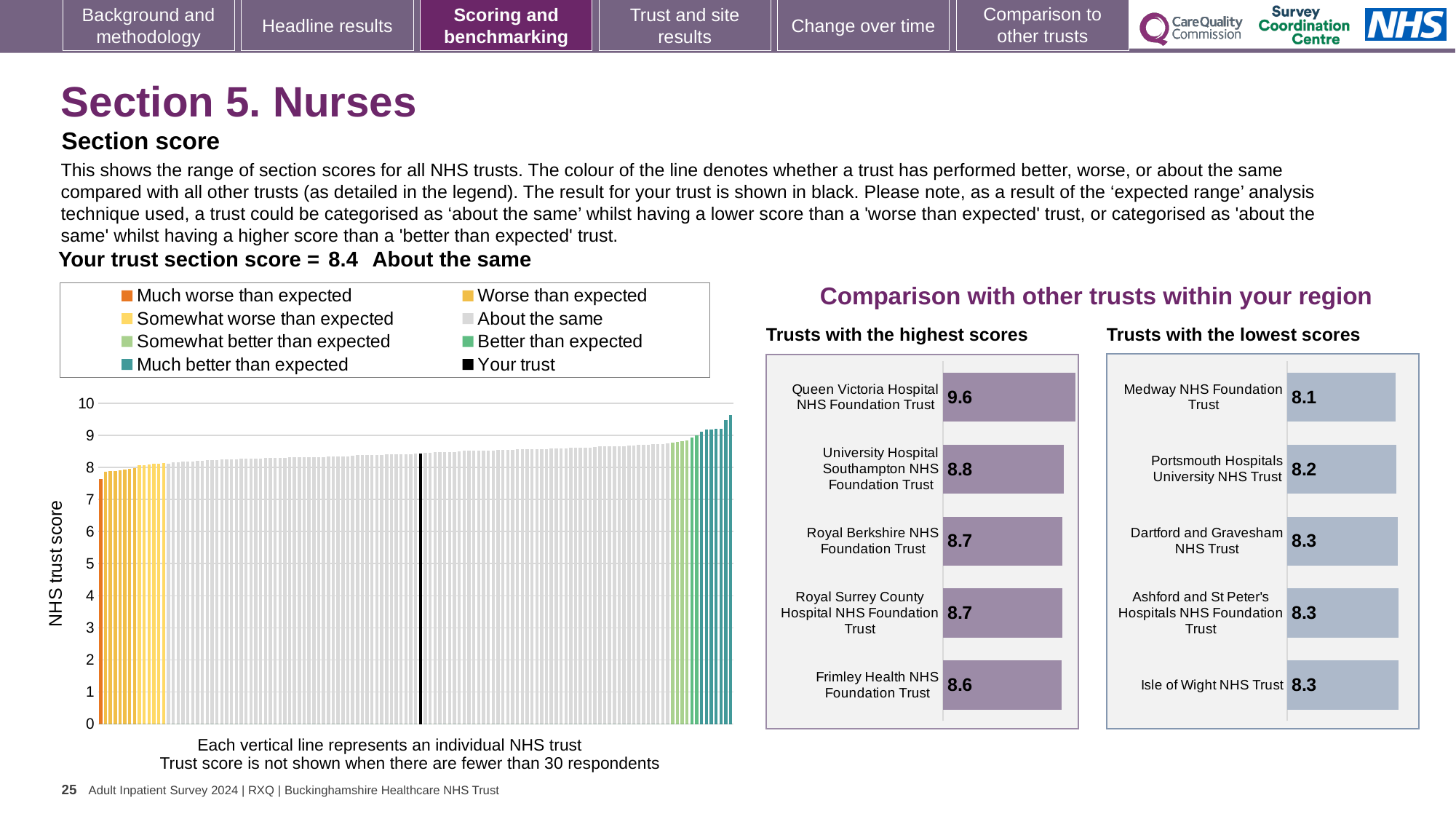
How many entries does the legend of the main 'NHS trust score' chart list? 8 In the main 'NHS trust score' chart, is the value for the black 'Your trust' bar greater or less than 8? greater In the 'Trusts with the highest scores' chart, what is the difference between the scores of Queen Victoria Hospital NHS Foundation Trust and Frimley Health NHS Foundation Trust? 1.0 In the 'Trusts with the highest scores' chart, what is the score for Queen Victoria Hospital NHS Foundation Trust? 9.6 In the 'Trusts with the highest scores' chart, which trust has the highest score? Queen Victoria Hospital NHS Foundation Trust What kind of chart is the main 'NHS trust score' chart on the left? Bar chart In the 'Trusts with the highest scores' chart, which has the higher score: University Hospital Southampton NHS Foundation Trust or Royal Berkshire NHS Foundation Trust? University Hospital Southampton NHS Foundation Trust In the 'Trusts with the lowest scores' chart, which trust has the lowest score? Medway NHS Foundation Trust In the main 'NHS trust score' chart, do the values rise or fall from left to right along the x axis? Rise In the 'Trusts with the lowest scores' chart, what is the score for Medway NHS Foundation Trust? 8.1 How many trusts are shown in the 'Trusts with the lowest scores' chart? 5 What is the title of the section containing the two small bar charts on the right of the slide? Comparison with other trusts within your region